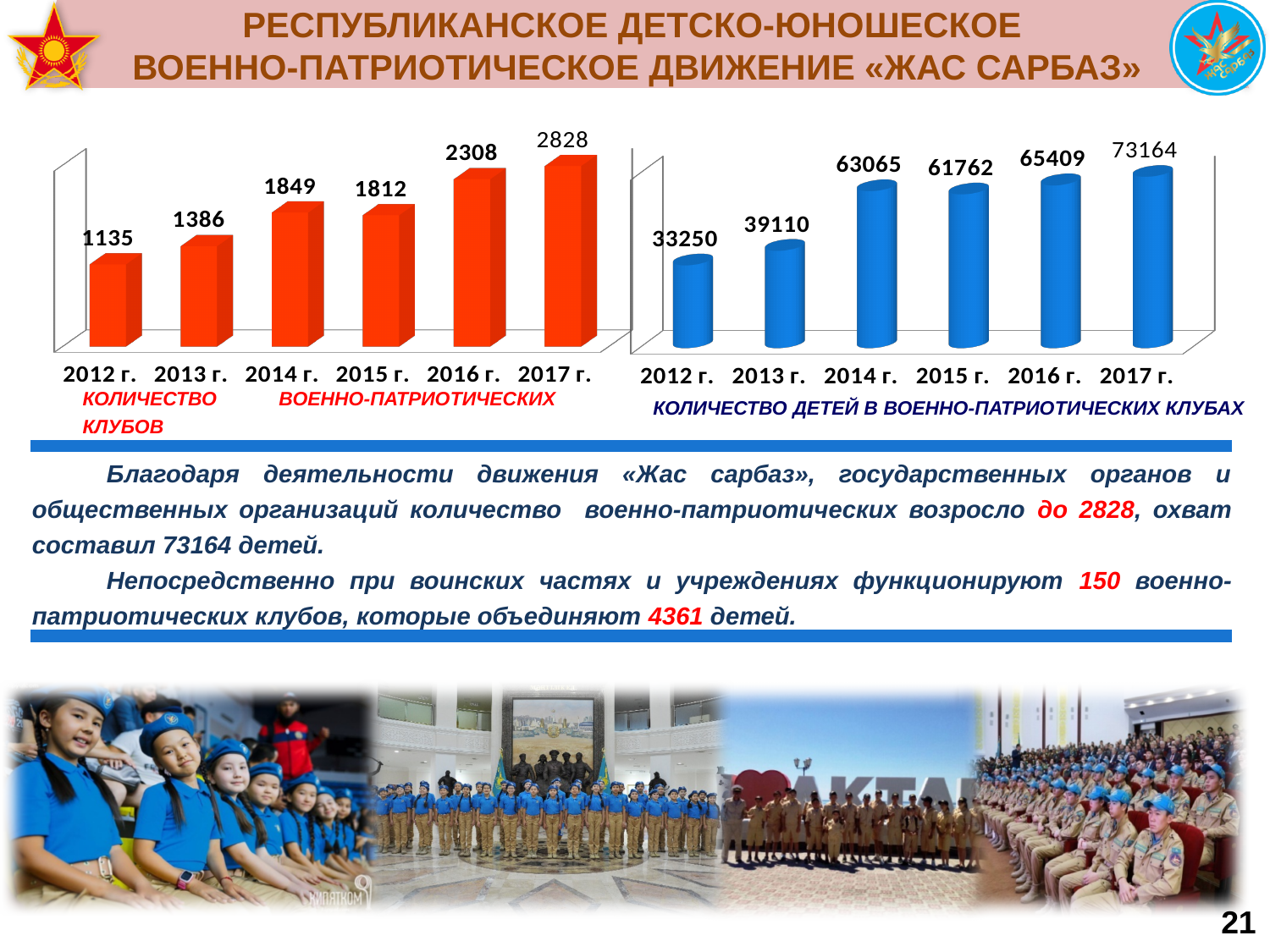
What type of chart is the right chart? bar chart In the right chart, what is the difference between the values for 2014 г. and 2015 г.? 1303 In the right chart, which year has the lowest number of children? 2012 г. In the left chart (number of military-patriotic clubs), what is the value for 2014 г.? 1849 How many years (categories) are shown in the left chart? 6 In the right chart, which is larger: the value for 2016 г. or 2017 г.? 2017 г. In the left chart, which is larger: the value for 2014 г. or 2015 г.? 2014 г. What colour are the bars in the left chart? red In the right chart, do the values generally rise or fall from 2012 г. to 2017 г.? rise In the left chart, which year has the highest number of clubs? 2017 г. In the right chart (number of children in military-patriotic clubs), what is the value for 2013 г.? 39110 In the left chart, what is the difference between the values for 2017 г. and 2016 г.? 520